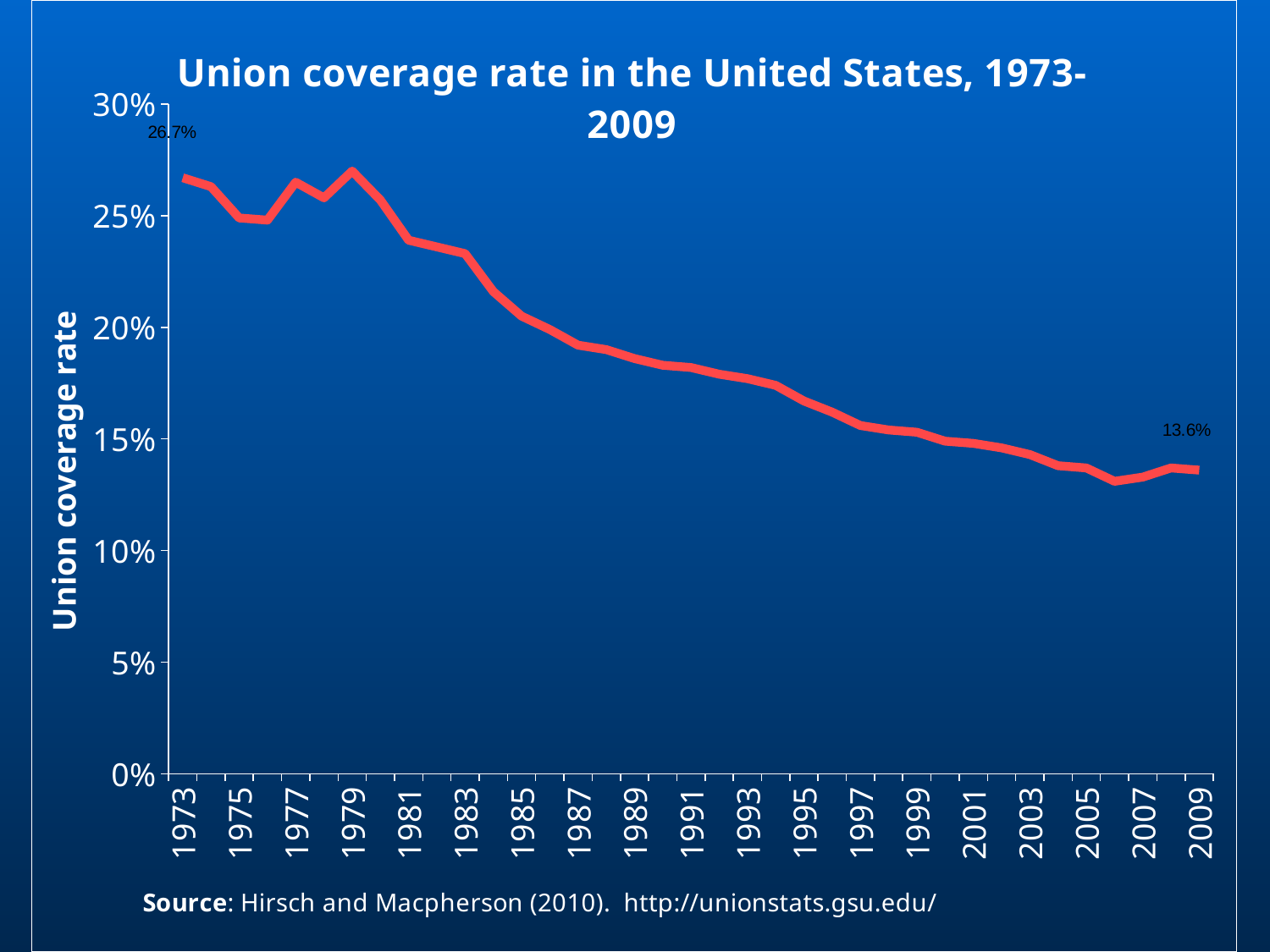
Which year had the higher union coverage rate, 1973 or 2009? 1973 What was the union coverage rate in 2009? 13.6% What is the title of the chart? Union coverage rate in the United States, 1973-2009 Is the union coverage rate in 2005 greater or less than 15%? less What kind of chart is shown on the slide? Line chart What is the label on the vertical axis of the chart? Union coverage rate Is the union coverage rate in 1995 greater or less than 15%? greater What was the union coverage rate in 1973? 26.7% By how many percentage points did the union coverage rate fall between 1973 and 2009? 13.1 percentage points Does the union coverage rate generally rise or fall from 1973 to 2009? Fall Is the union coverage rate in 1987 greater or less than 20%? less